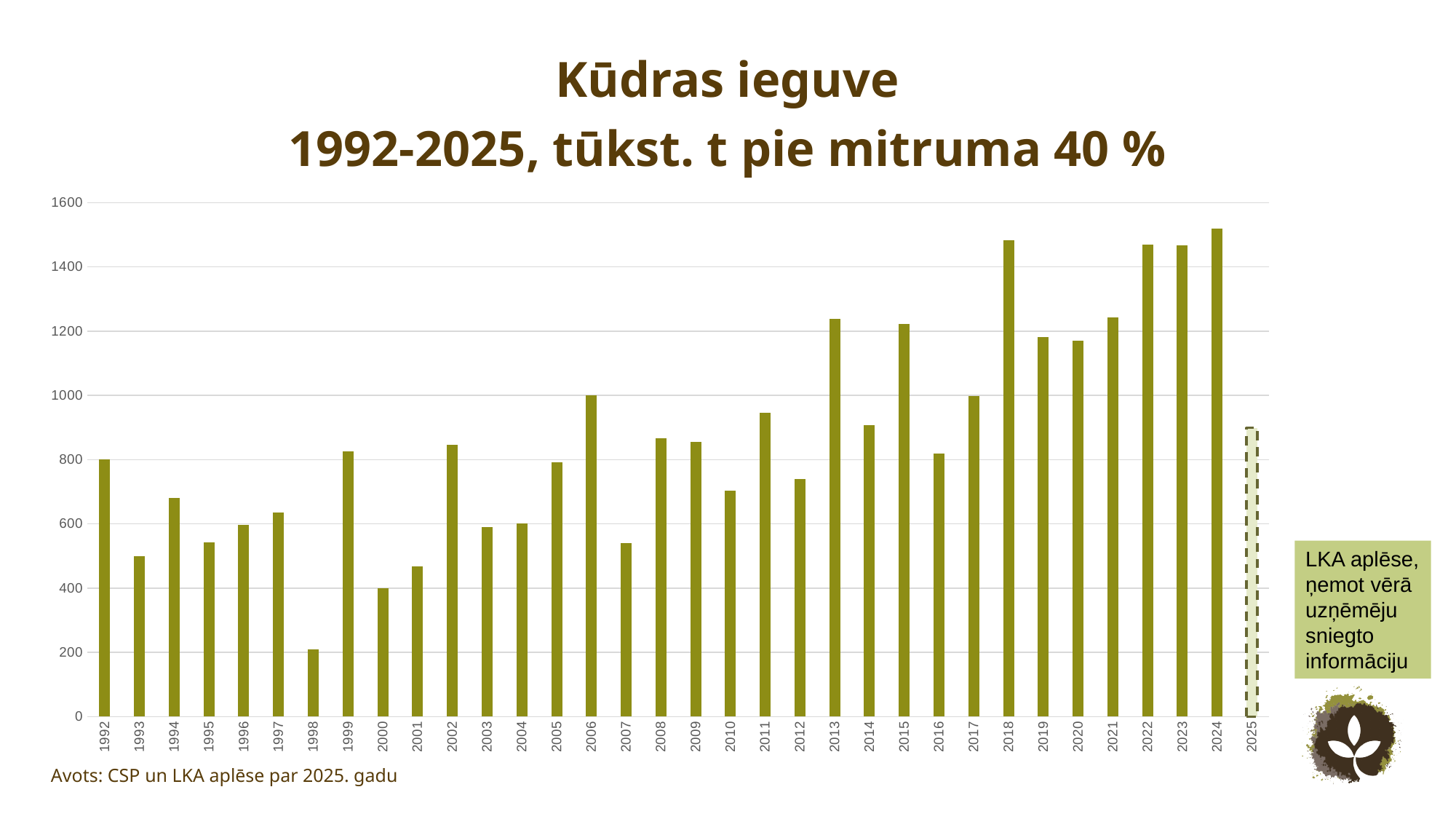
Is the value for 1998 greater or less than 400? less How many years (bars) are plotted in the chart? 34 Which year has the highest peat extraction value? 2024 Is the value for 2025 greater or less than 800? greater Overall, do the values rise or fall from 1992 to 2024? rise Is the value for 2007 greater or less than 600? less Which year has the lowest peat extraction value? 1998 What is the title of the chart? Kūdras ieguve 1992-2025, tūkst. t pie mitruma 40 % What kind of chart is shown on the slide? bar chart Which year has the larger value, 2013 or 2014? 2013